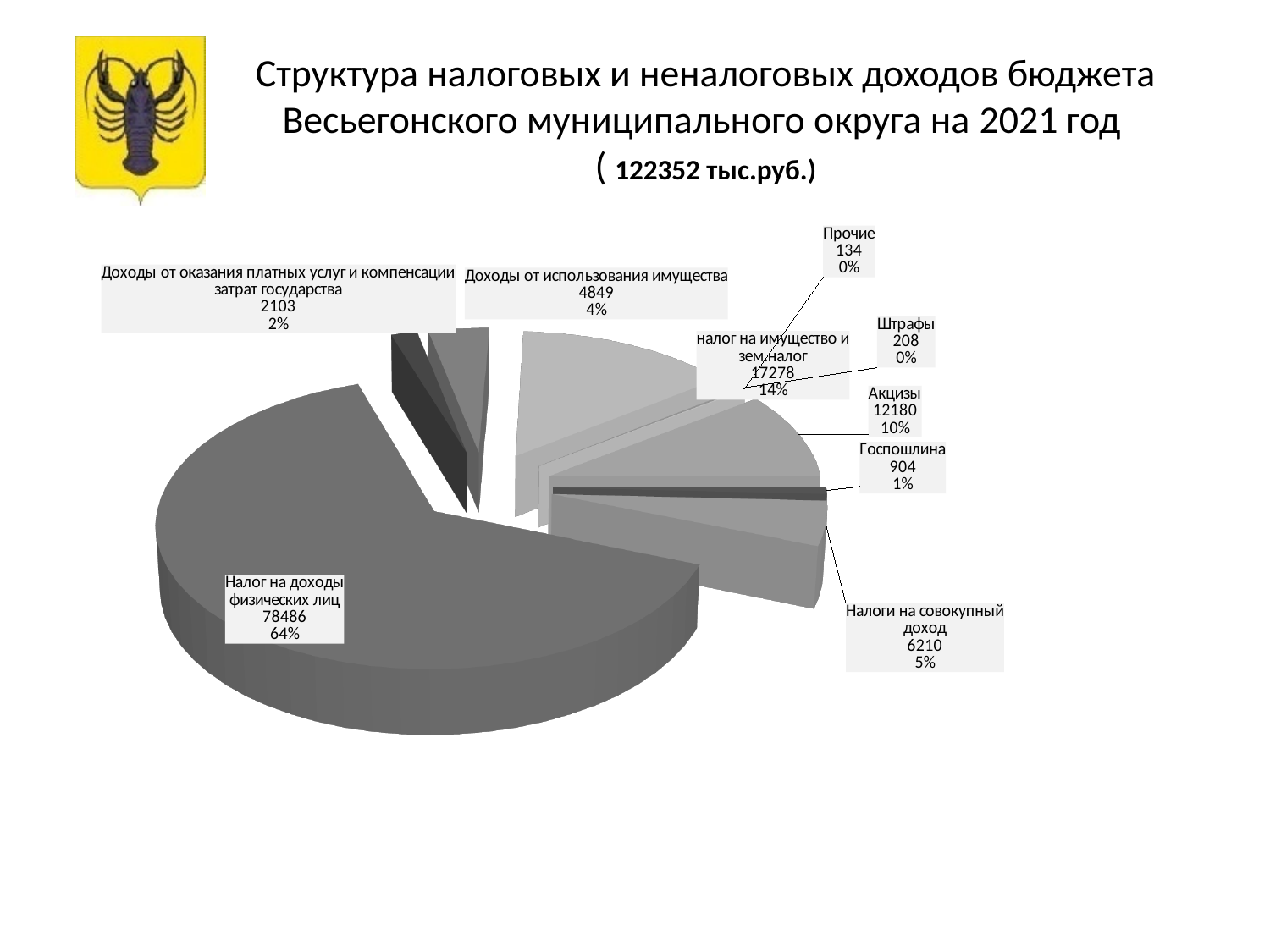
What is the value for налог на имущество и зем.налог? 17278 What is the value for Акцизы? 12180 What is the value for Налог на доходы физических лиц? 78486 What is the difference between the values for Акцизы and Налоги на совокупный доход? 5970 Which category has the smallest value? Прочие Which category has the largest slice of the pie? Налог на доходы физических лиц What share of the pie does Налоги на совокупный доход represent? 5% What kind of chart is shown on the slide? Pie chart What share of the pie does Налог на доходы физических лиц represent? 64% How many categories are shown in the pie chart? 9 Which is larger, Госпошлина or Штрафы? Госпошлина What is the value for Доходы от использования имущества? 4849